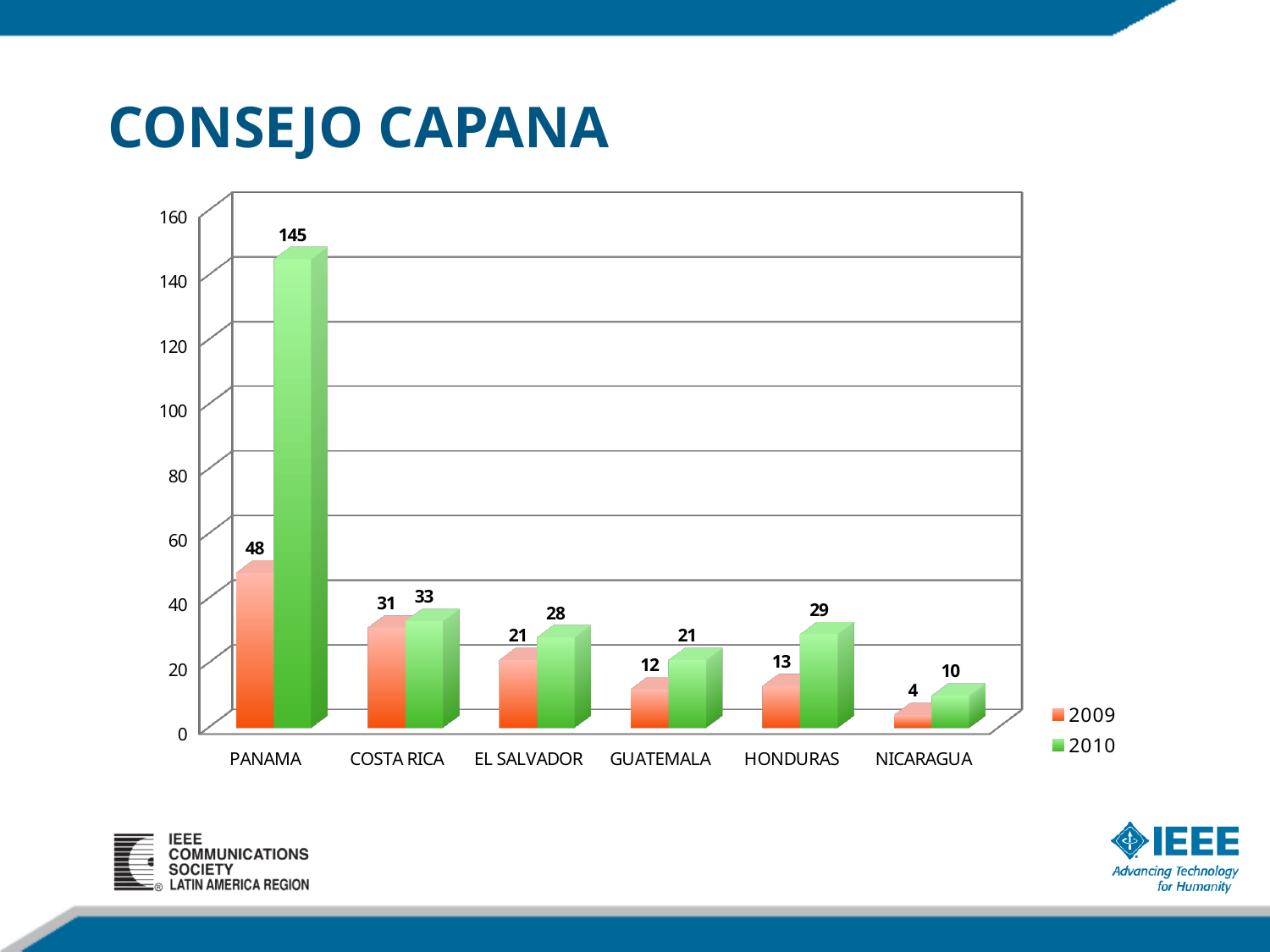
What kind of chart is shown on the slide? Bar chart Which country has the highest 2010 value? PANAMA Which is larger, the 2010 value for COSTA RICA or the 2010 value for HONDURAS? COSTA RICA What is the 2009 value for NICARAGUA? 4 What is the difference between the 2010 and 2009 values for HONDURAS? 16 How many countries are shown on the x axis? 6 What is the title of the slide? CONSEJO CAPANA How many series does the legend list? 2 Which country has the lowest 2009 value? NICARAGUA What is the 2010 value for PANAMA? 145 What is the difference between the 2010 and 2009 values for PANAMA? 97 What is the 2009 value for HONDURAS? 13